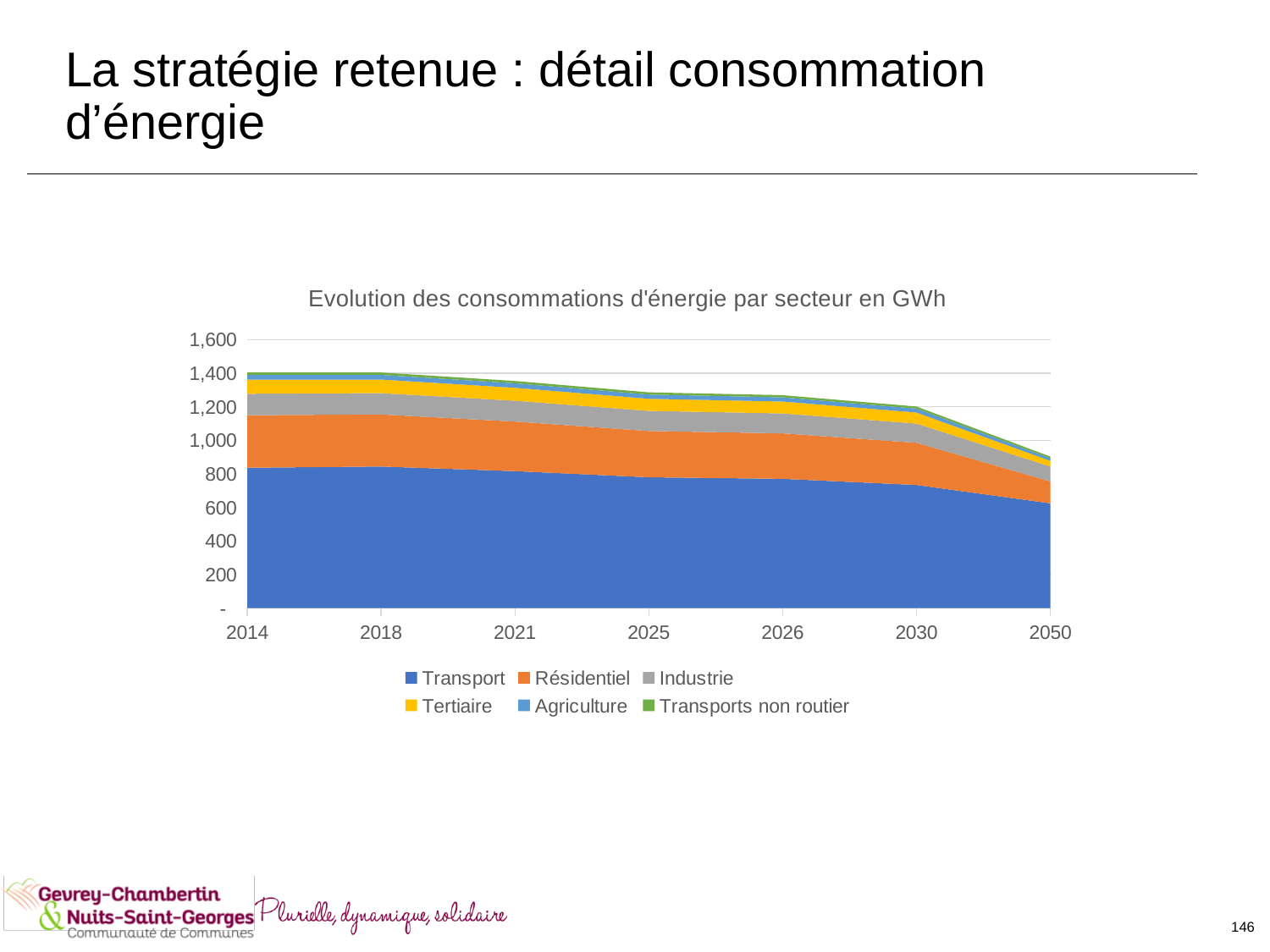
Is the Transport value in 2050 greater or less than 800 GWh? less Which colour represents the Résidentiel series in the legend? Orange What is the title of the chart? Evolution des consommations d'énergie par secteur en GWh Which year has the lowest total energy consumption? 2050 Is the total consumption in 2050 greater or less than 1,000 GWh? less What kind of chart is shown on the slide? Stacked area chart Does the total energy consumption rise or fall from 2014 to 2050? Fall How many series does the legend list? 6 Which sector accounts for the largest share of consumption in 2014, Transport or Résidentiel? Transport How many years are shown along the x axis? 7 Is the Transport value in 2014 greater or less than 1,000 GWh? less